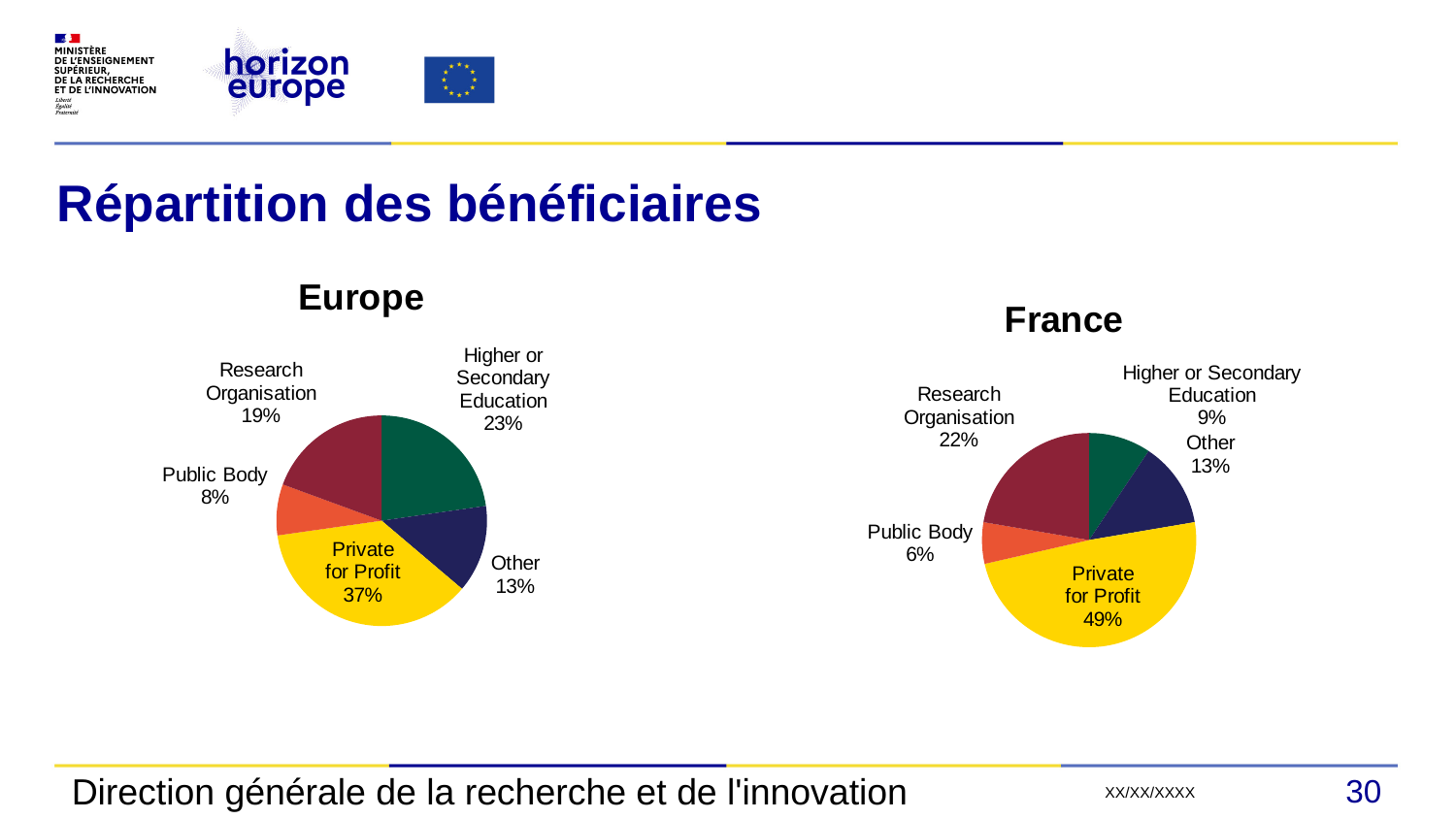
In the Europe pie chart, which category has the largest share? Private for Profit What is the title of the chart on the right side of the slide? France In the Europe pie chart, what share do Private for Profit beneficiaries have? 37% In the France pie chart, which category has the smallest share? Public Body In the Europe pie chart, what is the difference between the Higher or Secondary Education share and the Other share? 10% Which is larger in the France pie chart: Higher or Secondary Education or Other? Other What type of chart is used for the Europe data? Pie chart In the France pie chart, what share do Research Organisation beneficiaries have? 22% Which is larger in the Europe pie chart: Research Organisation or Higher or Secondary Education? Higher or Secondary Education In the Europe pie chart, which category has the smallest share? Public Body What is the difference between the Private for Profit share in the France chart and in the Europe chart? 12% How many categories does the France pie chart show? 5